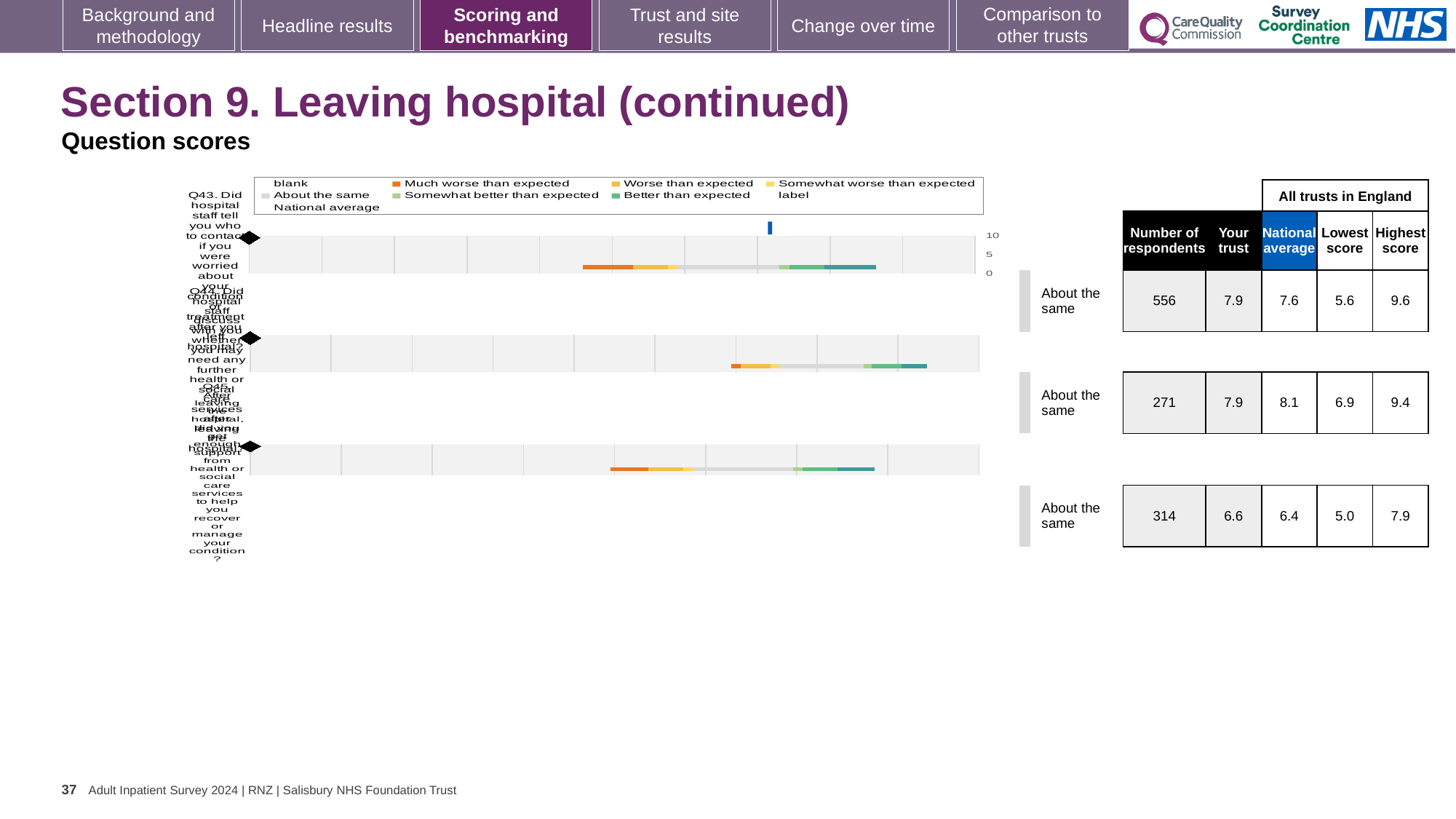
What kind of chart is used on this slide to show the question scores? bar chart In the chart legend, what colour is used for 'Much worse than expected'? orange In the table beside the second (middle) chart, what is the national average score? 8.1 For the first (top) chart, which is larger: the 'Your trust' score or the national average? Your trust In the table beside the first (top) chart, what is the 'Your trust' score? 7.9 In the table beside the third (bottom) chart, what is the highest score among all trusts in England? 7.9 What benchmark category label is shown next to each of the three charts? About the same In the table beside the first (top) chart, what is the lowest score among all trusts in England? 5.6 In the table beside the first (top) chart, what is the number of respondents? 556 For the third (bottom) chart, what is the difference between the 'Your trust' score (6.6) and the national average (6.4)? 0.2 What is the highest tick value shown on the chart axis? 10 How many separate benchmark bar charts are shown on the slide? 3